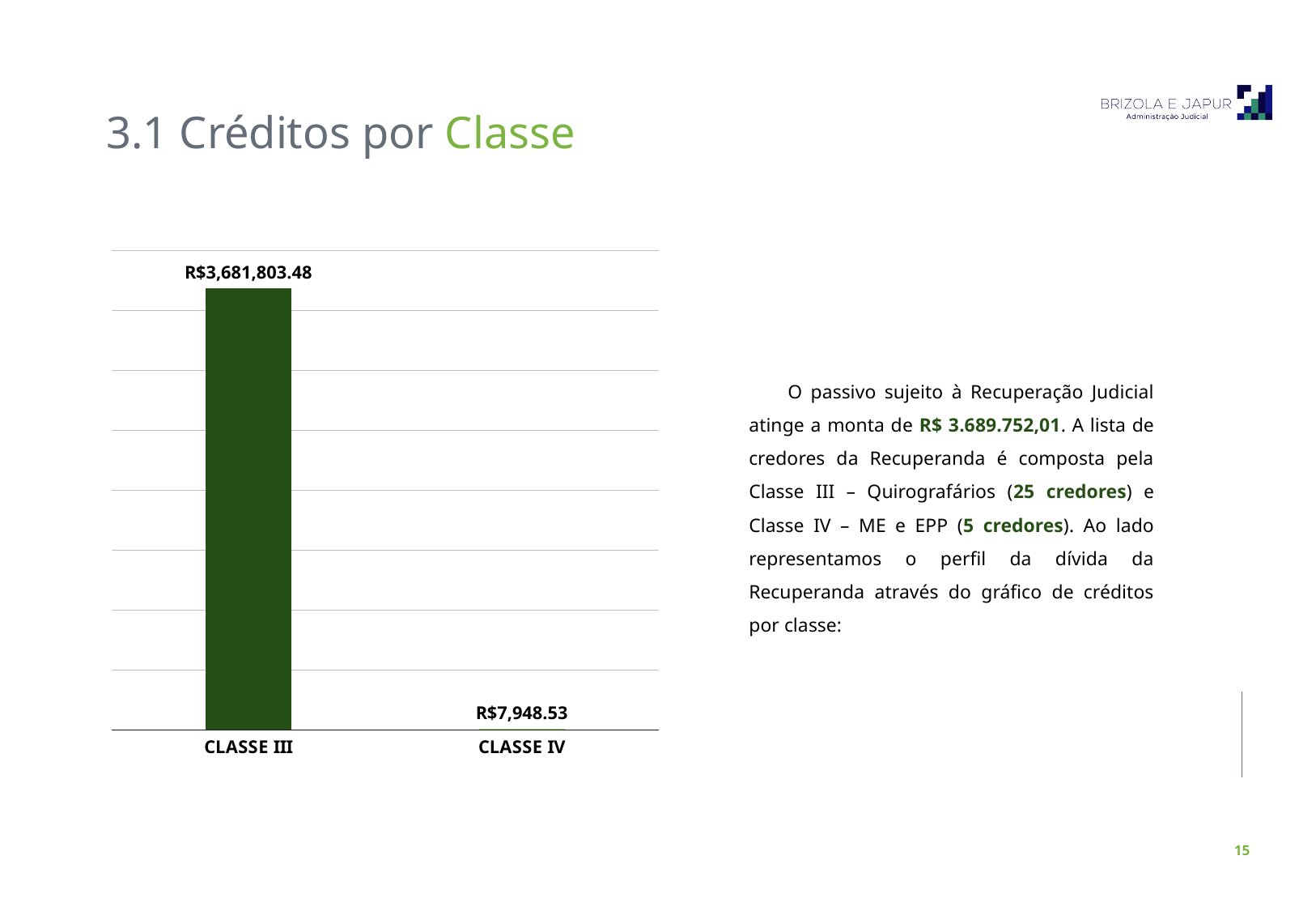
Which is larger, the value for CLASSE III or the value for CLASSE IV? CLASSE III What is the difference between the values for CLASSE III and CLASSE IV? R$3,673,854.95 Which class has the lowest value in the chart? CLASSE IV What colour are the bars in the chart? Dark green Do the values rise or fall from CLASSE III to CLASSE IV? Fall What is the value shown for CLASSE III? R$3,681,803.48 What is the title of the slide containing the chart? 3.1 Créditos por Classe What is the value shown for CLASSE IV? R$7,948.53 What is the combined total of the values for CLASSE III and CLASSE IV? R$3,689,752.01 How many categories are shown in the chart? 2 Which class has the highest value in the chart? CLASSE III What kind of chart is shown on the slide? Bar chart